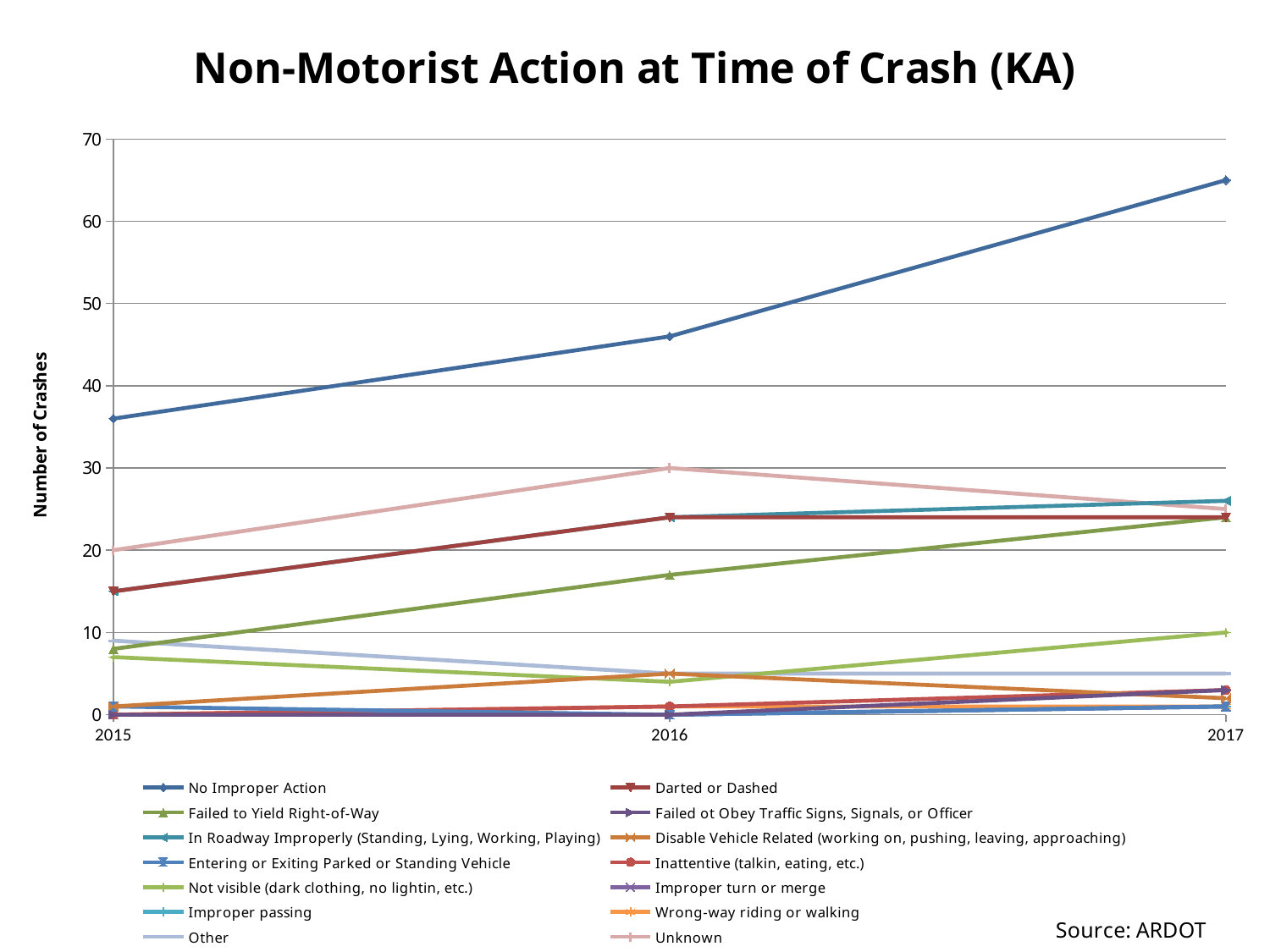
Is the value for Darted or Dashed in 2016 greater or less than 20? greater What is the title of the chart? Non-Motorist Action at Time of Crash (KA) Is the value for Failed to Yield Right-of-Way in 2015 greater or less than 10? less What is the label on the y axis? Number of Crashes How many years are plotted along the x axis? 3 Does the value for No Improper Action rise or fall from 2015 to 2017? rise Is the value for No Improper Action in 2017 greater or less than 60? greater Which is larger in 2016, the value for No Improper Action or the value for Unknown? No Improper Action How many series does the legend list? 14 Which series has the highest value in 2017? No Improper Action What kind of chart is shown on the slide? line chart